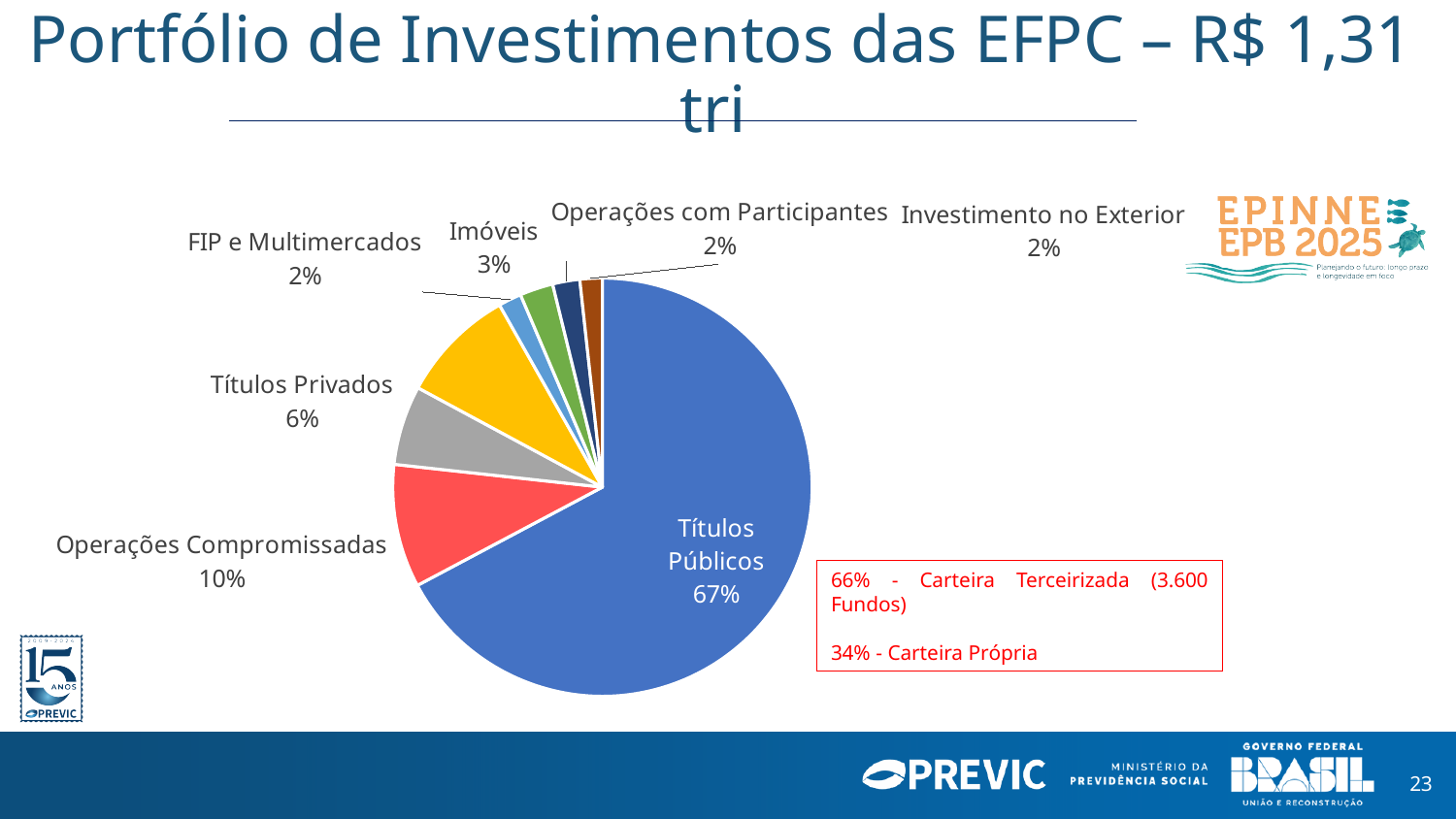
What is the value shown for FIP e Multimercados? 2% What kind of chart is shown on the slide? pie chart What is the value shown for Investimento no Exterior? 2% What is the difference between the shares of Operações Compromissadas and Títulos Privados? 4% Which is larger, Títulos Privados or Imóveis? Títulos Privados Which category has the largest slice of the pie? Títulos Públicos What share of the portfolio is Títulos Públicos? 67% What is the value shown for Imóveis? 3% What is the difference between the shares of Títulos Públicos and Operações Compromissadas? 57% What is the value shown for Títulos Privados? 6% What is the value shown for Operações Compromissadas? 10% What is the title of the slide containing the chart? Portfólio de Investimentos das EFPC – R$ 1,31 tri